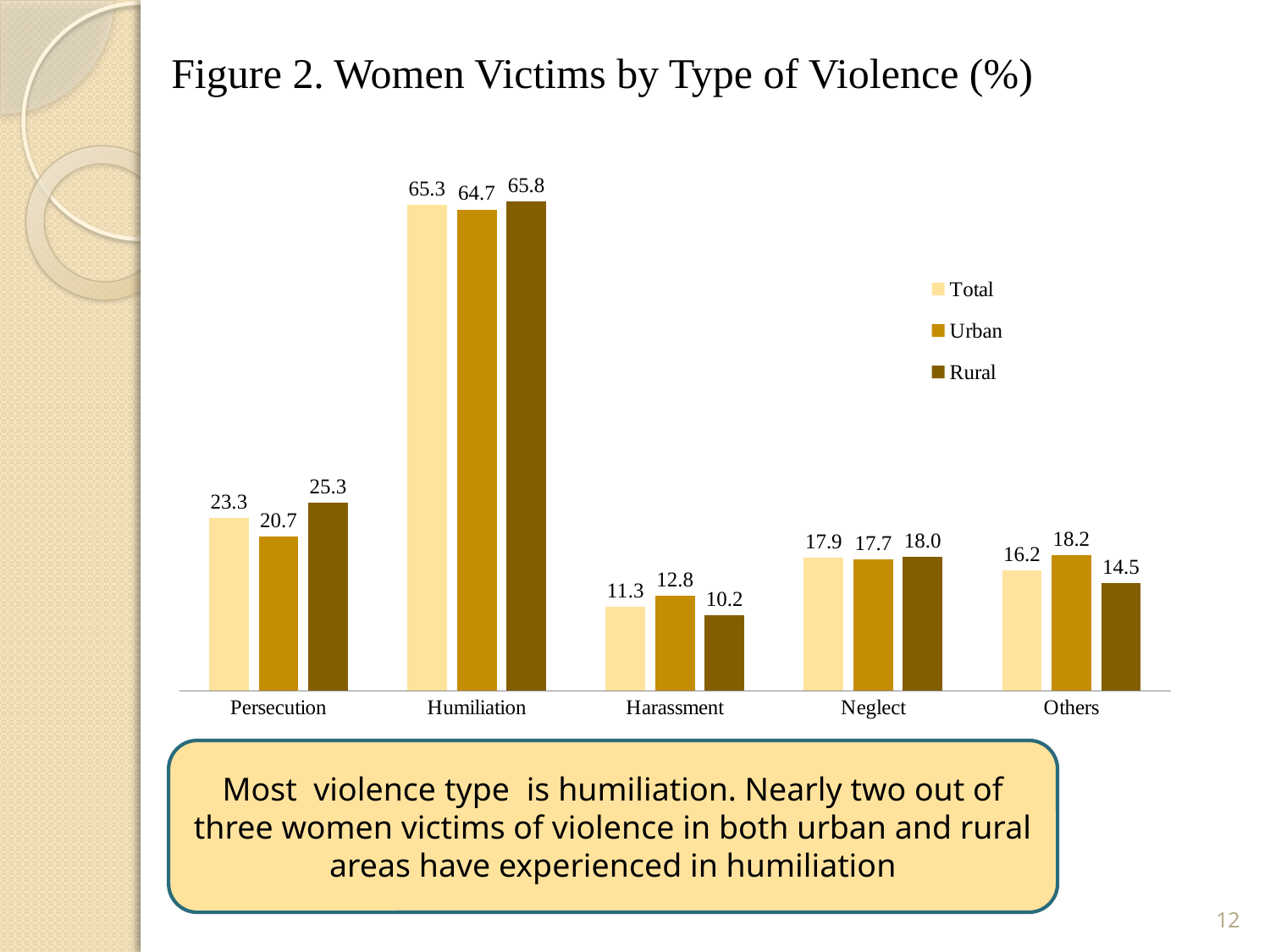
Which series is shown in the darkest brown colour? Rural What is the Rural value for Persecution? 25.3 Which is larger for Others: the Urban value or the Rural value? Urban What is the title of the chart? Figure 2. Women Victims by Type of Violence (%) Which type of violence has the lowest Rural value? Harassment What is the Urban value for Harassment? 12.8 Which type of violence has the highest Total value? Humiliation How many series does the legend list? 3 What is the difference between the Rural and Urban values for Persecution? 4.6 What is the Total value for Neglect? 17.9 How many types of violence are shown on the x axis? 5 What kind of chart is shown? Bar chart